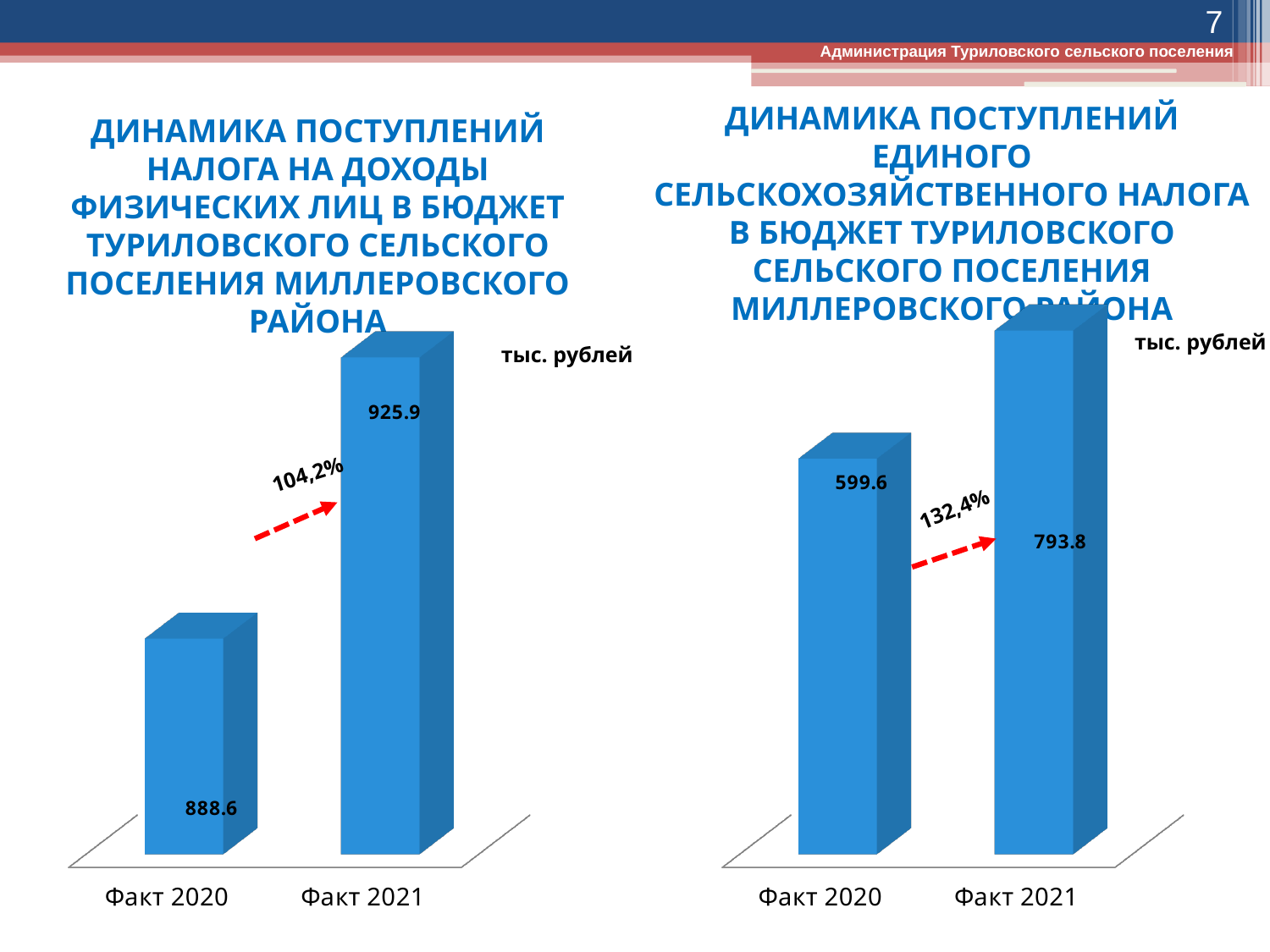
In the left chart, by how much did the value increase from Факт 2020 to Факт 2021? 37.3 In the right chart, which category has the higher value, Факт 2020 or Факт 2021? Факт 2021 What type of chart is the left chart? Bar chart What unit of measurement is indicated for the values in the right chart? тыс. рублей In the left chart (personal income tax receipts), what is the value for Факт 2020? 888.6 In the right chart (unified agricultural tax receipts), what is the value for Факт 2021? 793.8 In the left chart, what growth percentage is shown on the arrow between Факт 2020 and Факт 2021? 104,2% In the left chart (personal income tax receipts), what is the value for Факт 2021? 925.9 How many categories are shown in the right chart? 2 In the left chart, which category has the lowest value? Факт 2020 In the right chart (unified agricultural tax receipts), what is the value for Факт 2020? 599.6 In the right chart, what is the difference between the Факт 2021 and Факт 2020 values? 194.2